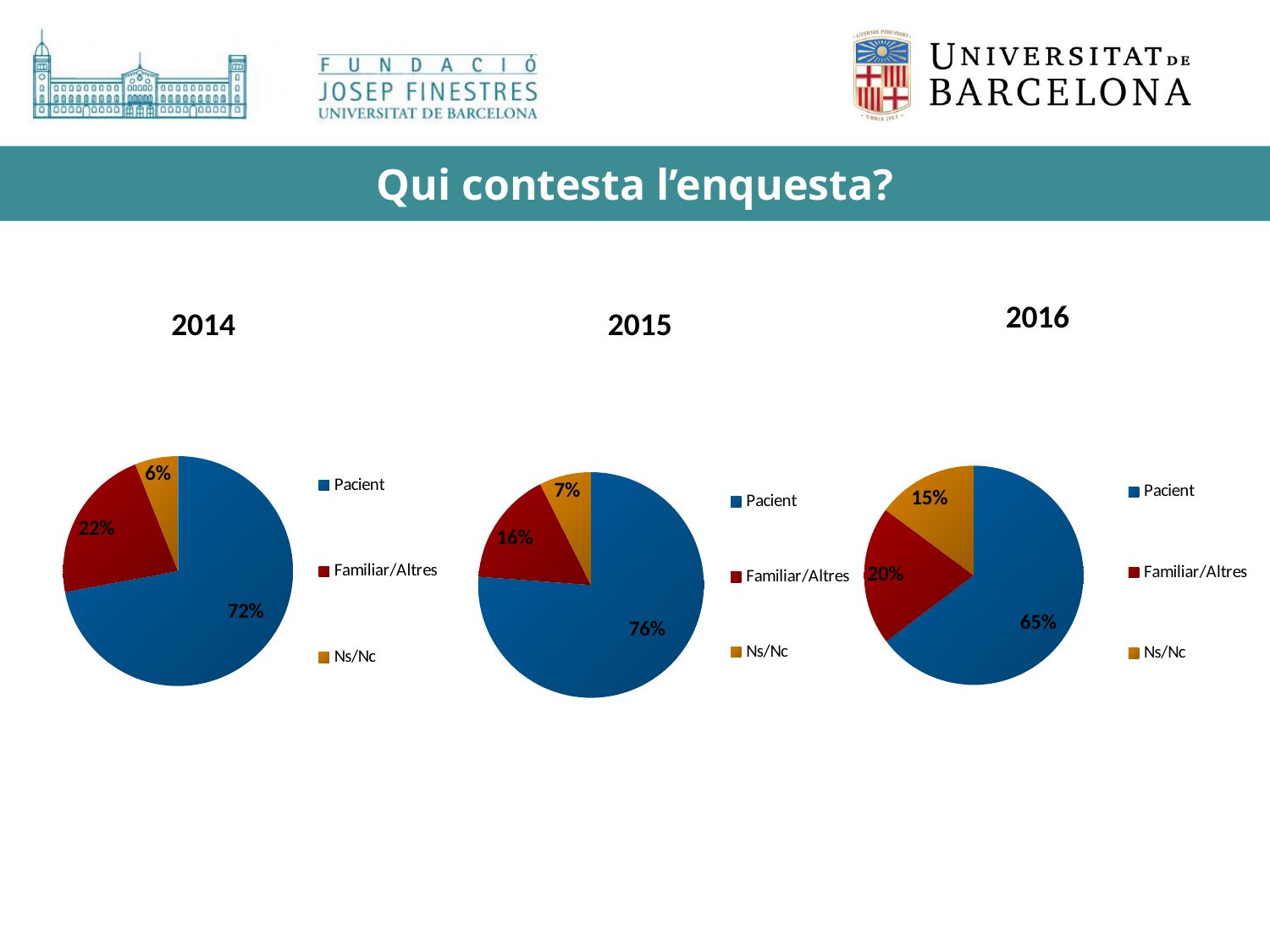
In the 2014 pie chart, what share is labelled for Pacient? 72% What kind of chart is used for the 2014 data? Pie chart In the 2015 pie chart, what is the difference between the Pacient share and the Familiar/Altres share? 60% What colour is the Pacient slice in the 2015 pie chart? Blue How many slices does the 2015 pie chart have? 3 In the 2015 pie chart, what share is labelled for Familiar/Altres? 16% In the 2016 pie chart, what share is labelled for Ns/Nc? 15% In the 2014 pie chart, which category has the smallest slice? Ns/Nc In the 2016 pie chart, what is the difference between the Familiar/Altres share and the Ns/Nc share? 5% In the 2016 pie chart, which category has the largest slice? Pacient How many pie charts are shown on the slide? 3 Which is larger: the Familiar/Altres share in the 2014 chart or the Familiar/Altres share in the 2016 chart? 2014